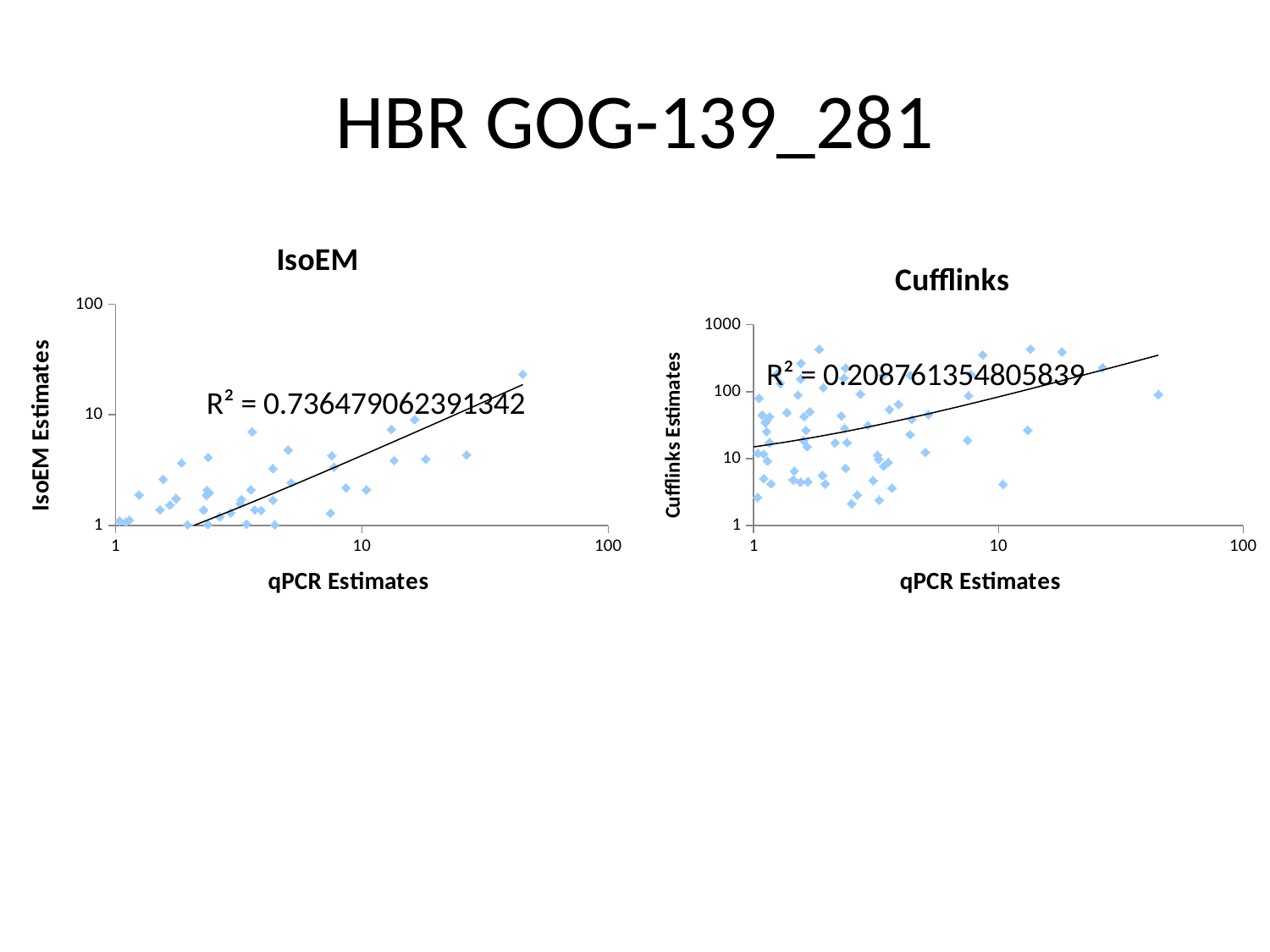
What is the highest tick value shown on the y-axis of the IsoEM chart? 100 What is the highest tick value shown on the y-axis of the Cufflinks chart? 1000 What kind of chart is the Cufflinks chart on the right? scatter chart On the Cufflinks chart, does the fitted trend line rise or fall as qPCR Estimates increase? rise What is the x-axis label on the IsoEM chart? qPCR Estimates What is the y-axis label on the Cufflinks chart? Cufflinks Estimates Is the R² value on the Cufflinks chart greater or less than 0.5? less What kind of chart is the IsoEM chart on the left? scatter chart What R² value is printed on the Cufflinks chart? 0.208761354805839 What R² value is printed on the IsoEM chart? 0.736479062391342 On the IsoEM chart, does the fitted trend line rise or fall as qPCR Estimates increase? rise Which chart shows the higher R² value, IsoEM or Cufflinks? IsoEM